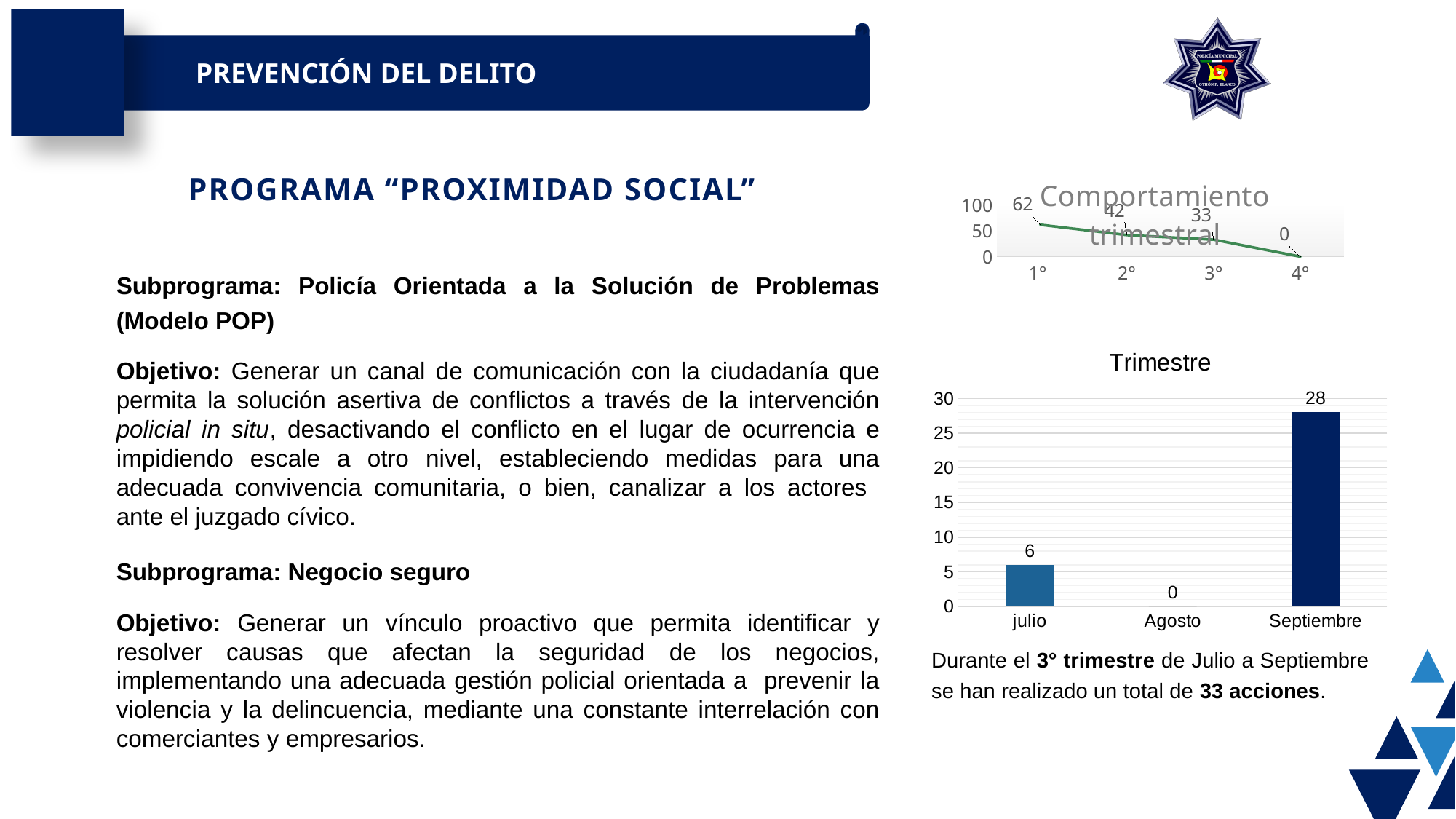
What kind of chart is the "Comportamiento trimestral" chart? line chart In the "Trimestre" chart, what is the value for Septiembre? 28 In the "Trimestre" chart, which month has the lowest value? Agosto In the "Comportamiento trimestral" chart, what is the value for 3°? 33 In the "Comportamiento trimestral" chart, what is the value for 1°? 62 What kind of chart is the "Trimestre" chart? bar chart In the "Comportamiento trimestral" chart, do the values rise or fall from 1° to 4°? fall In the "Trimestre" chart, what is the value for julio? 6 In the "Trimestre" chart, how many months are shown on the x axis? 3 In the "Trimestre" chart, which month has the highest value? Septiembre In the "Comportamiento trimestral" chart, what is the difference between the values for 1° and 2°? 20 In the "Trimestre" chart, what is the difference between the values for Septiembre and julio? 22